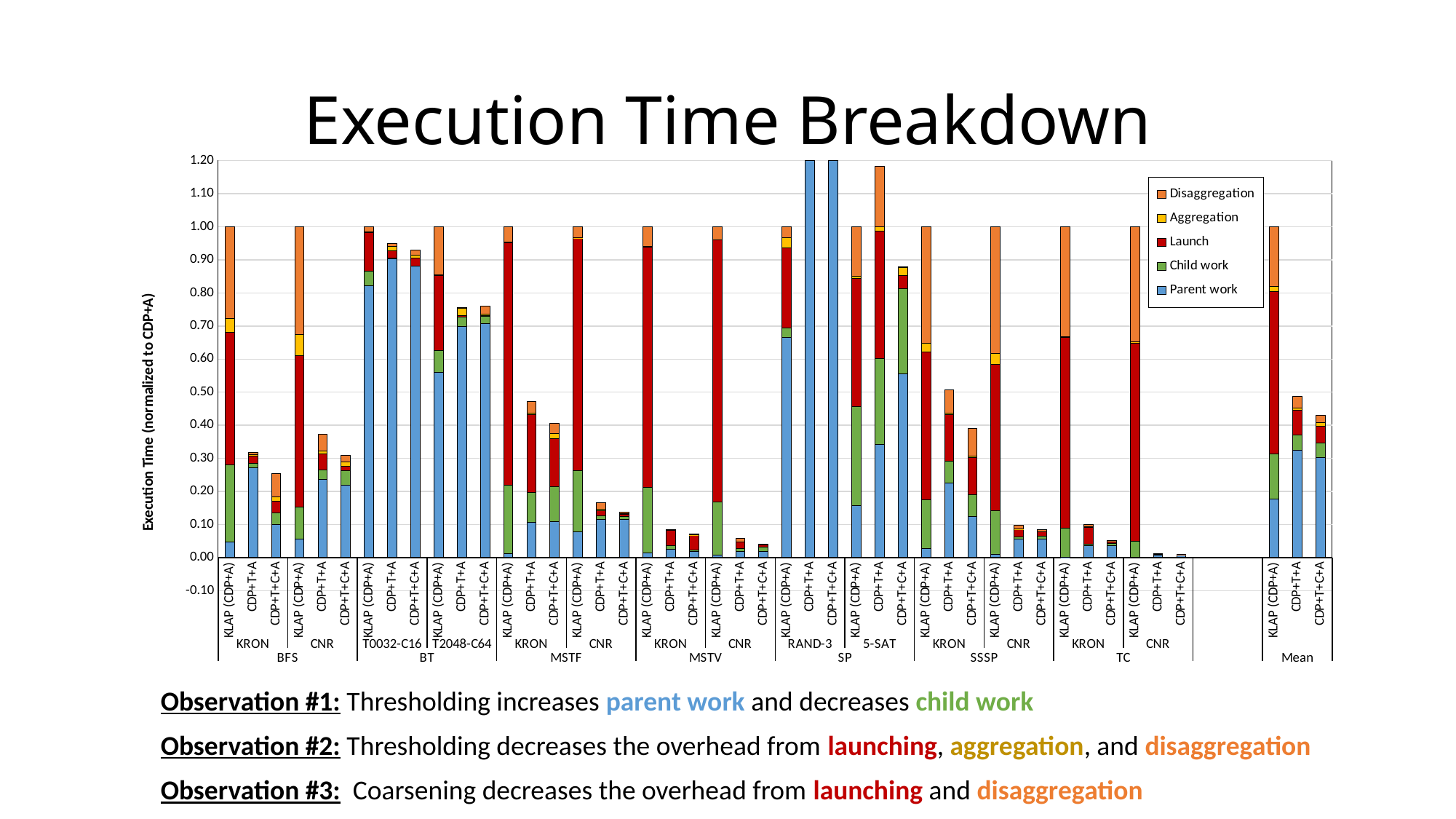
Is the total for CDP+T+A under Mean greater or less than 0.40? greater Is the total for CDP+T+A for T0032-C16 under BT greater or less than 0.90? greater What is the title of the chart? Execution Time Breakdown What is the total height of the KLAP (CDP+A) bar for KRON under BFS? 1.00 How many series does the legend list? 5 Is the total for CDP+T+A for KRON under MSTV greater or less than 0.20? less Which is larger for CNR under TC: the total for KLAP (CDP+A) or the total for CDP+T+A? KLAP (CDP+A) Which series is shown in blue in the legend? Parent work Which is larger for KRON under MSTF: the total for CDP+T+A or the total for CDP+T+C+A? CDP+T+A What type of chart is shown on the slide? Stacked bar chart